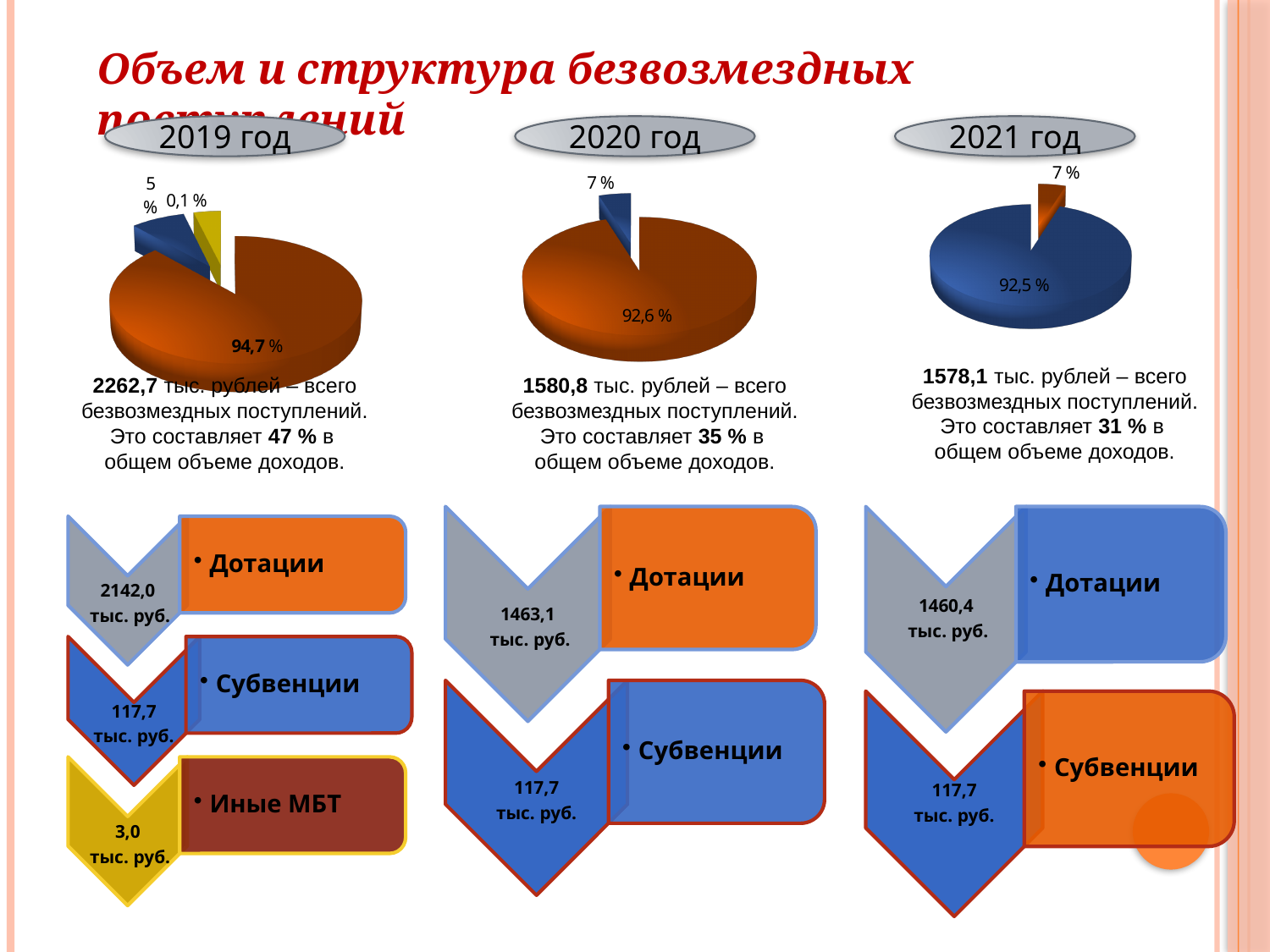
In the 2020 pie chart, what percentage is shown for the largest slice? 92,6 % In the 2019 pie chart, what is the difference between the 5 % slice and the 0,1 % slice? 4,9 % How many slices does the 2021 pie chart have? 2 What type of charts are shown on the slide for 2019, 2020 and 2021? Pie charts In the 2020 pie chart, what percentage is shown for the smaller slice? 7 % In the 2019 pie chart, what is the smallest percentage labelled? 0,1 % What is the difference between the largest slice in the 2019 pie chart and the largest slice in the 2021 pie chart? 2,2 % How many slices does the 2019 pie chart have? 3 In the 2021 pie chart, what percentage is shown for the largest slice? 92,5 % What is the title of the slide containing the three pie charts? Объем и структура безвозмездных поступлений Which year's pie chart has the largest share for its biggest slice: 2019, 2020 or 2021? 2019 In the 2019 pie chart, what percentage is shown for the largest slice? 94,7 %